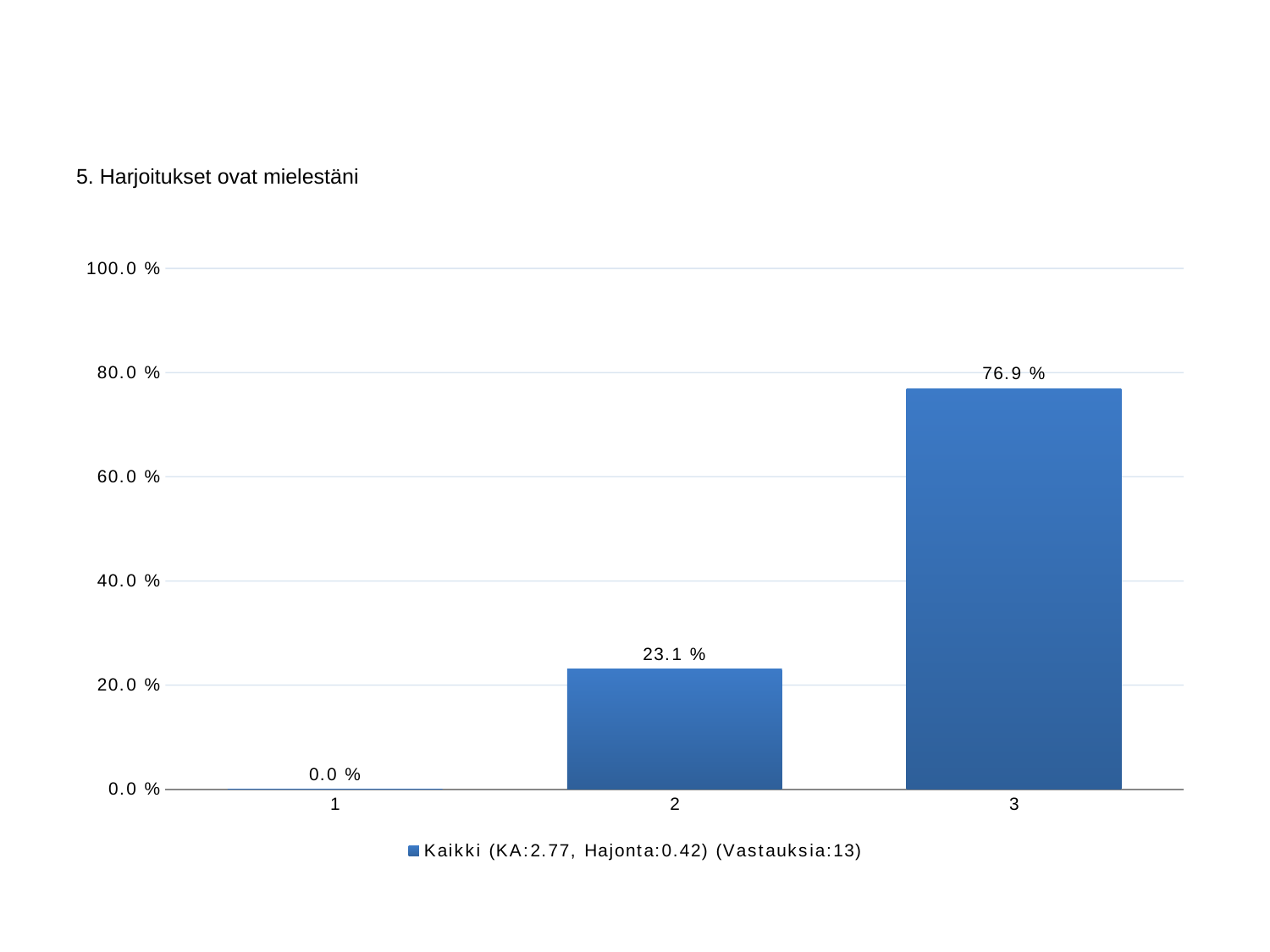
How many series does the legend list? 1 What kind of chart is shown? bar chart What is the value for category 1? 0.0 % What is the value for category 2? 23.1 % Do the values rise or fall from category 1 to category 3? rise Which category has the lowest value? 1 What is the difference between the values for category 3 and category 2? 53.8 % Which is larger, the value for category 2 or category 3? 3 What is the value for category 3? 76.9 % How many categories are shown on the x axis? 3 Which category has the highest value? 3 Is the value for category 3 greater or less than 60.0 %? greater